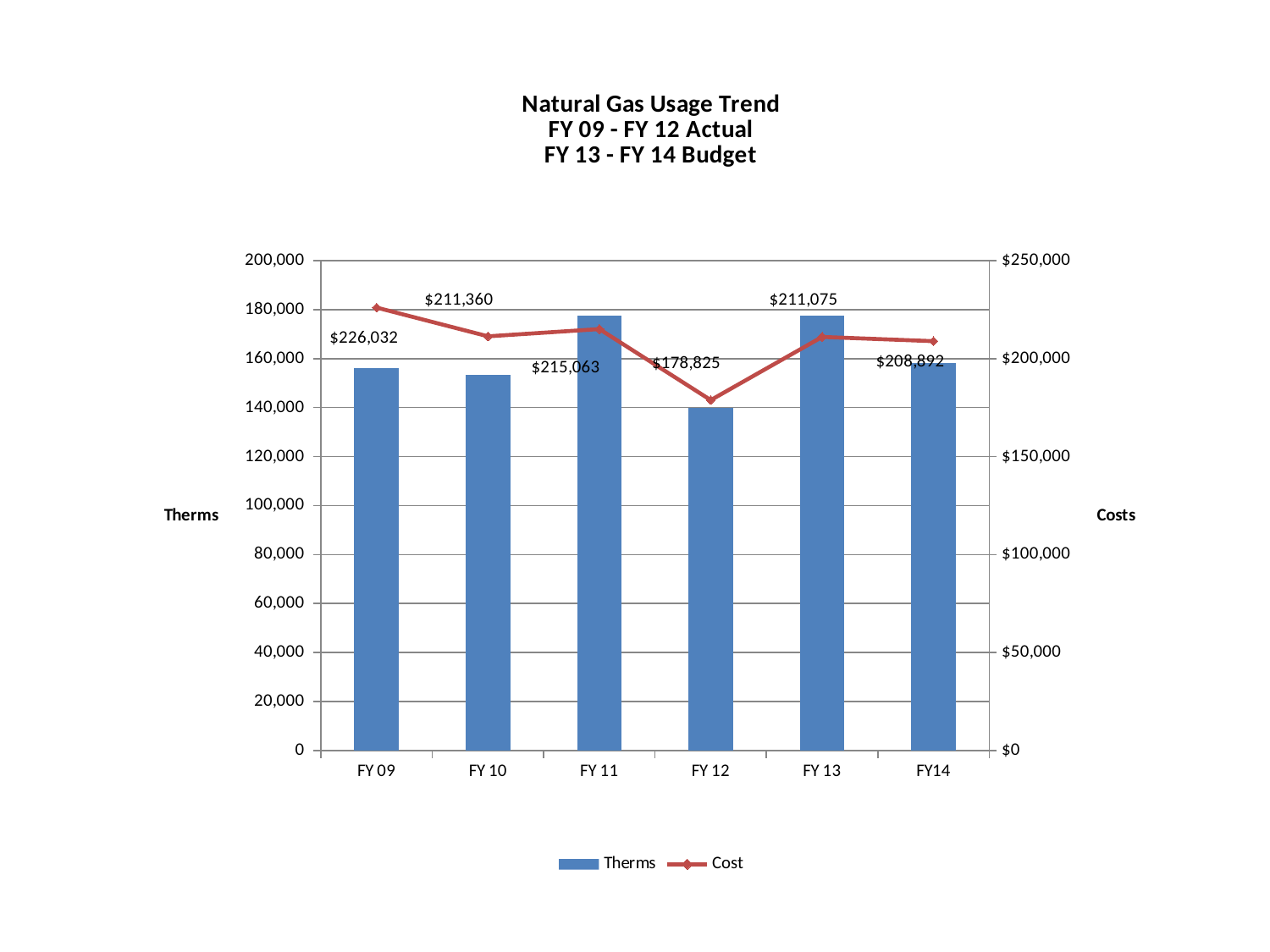
Does the Cost rise or fall from FY 11 to FY 12? fall Which fiscal year has the highest Cost? FY 09 Is the Therms value for FY 11 greater or less than 160,000? greater Is the Therms value for FY 12 greater or less than 160,000? less What is the Cost value for FY14? $208,892 What is the Cost value for FY 12? $178,825 What is the difference between the Cost for FY 09 and the Cost for FY 12? $47,207 How many series does the legend list? 2 What is the Cost value for FY 09? $226,032 How many fiscal years are shown on the x axis? 6 Which has the larger Cost, FY 10 or FY 11? FY 11 Which fiscal year has the lowest Cost? FY 12